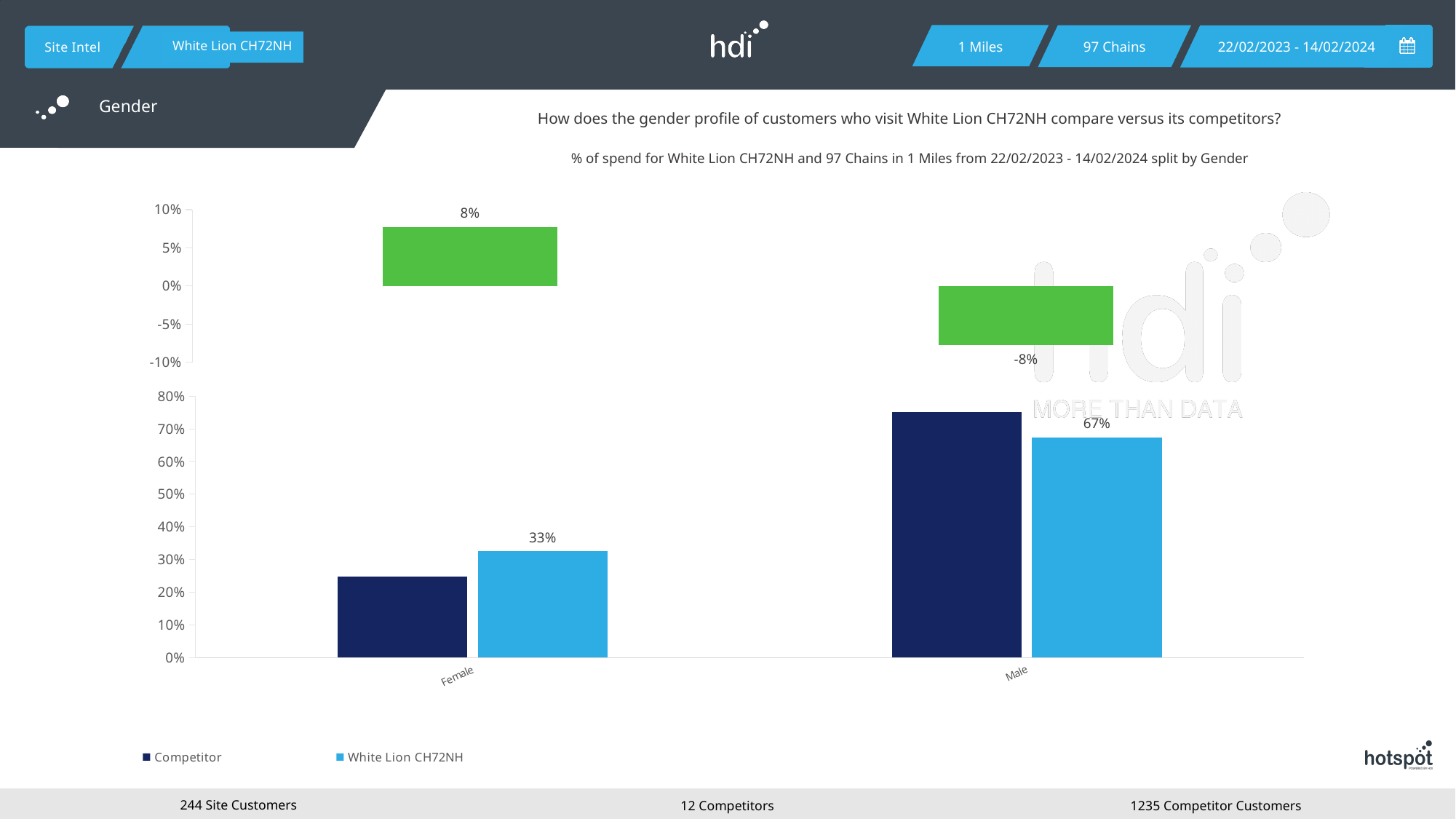
In the bottom chart, is the Competitor value for Female greater or less than 30%? less How many categories are shown on the x axis of the bottom chart? 2 What type of chart is the bottom chart? bar chart In the bottom chart, which category has the higher value for White Lion CH72NH, Female or Male? Male In the top chart, what is the value shown for the Female category? 8% How many series does the legend of the bottom chart list? 2 In the bottom chart, what is the value for White Lion CH72NH in the Female category? 33% In the bottom chart, which series has the higher value in the Male category, Competitor or White Lion CH72NH? Competitor In the bottom chart, what is the value for White Lion CH72NH in the Male category? 67% In the bottom chart, what is the difference between the White Lion CH72NH values for Male and Female? 34% In the top chart, what is the value shown for the Male category? -8% In the bottom chart, is the Competitor value for Male greater or less than 70%? greater